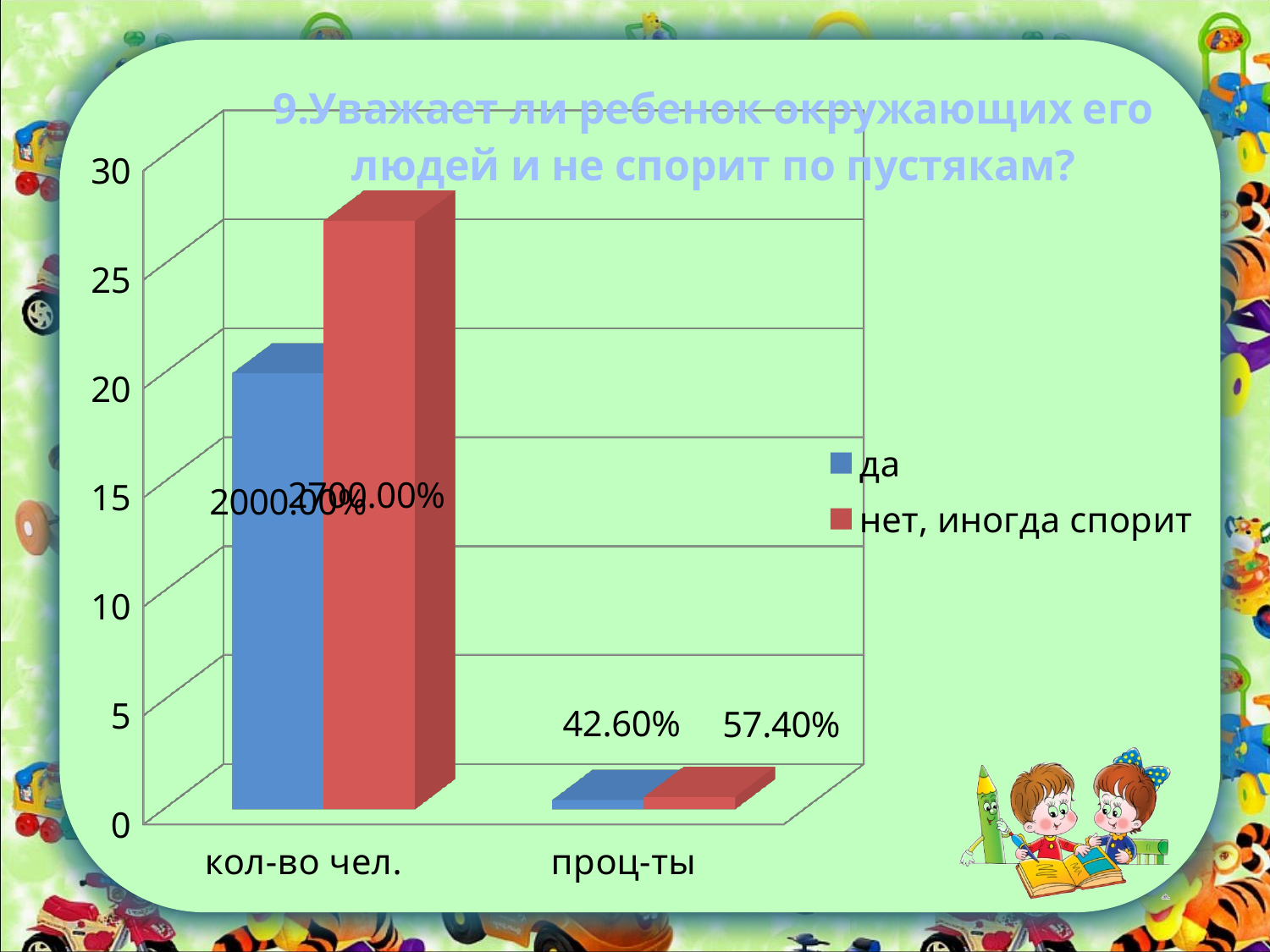
How many categories are shown on the x axis? 2 What is the difference between the "нет, иногда спорит" and "да" values in the "проц-ты" category? 14.80% Is the value for "да" in the "кол-во чел." category greater or less than 25? less What is the value for "нет, иногда спорит" in the "проц-ты" category? 57.40% In the "проц-ты" category, which series has the larger value, "да" or "нет, иногда спорит"? нет, иногда спорит How many series does the legend list? 2 Is the value for "нет, иногда спорит" in the "кол-во чел." category greater or less than 25? greater Is the value for "да" in the "кол-во чел." category greater or less than 15? greater In the "кол-во чел." category, which series has the taller bar, "да" or "нет, иногда спорит"? нет, иногда спорит Which bar is the tallest on the chart? нет, иногда спорит in кол-во чел. What is the value for "да" in the "проц-ты" category? 42.60% What kind of chart is shown on the slide? bar chart